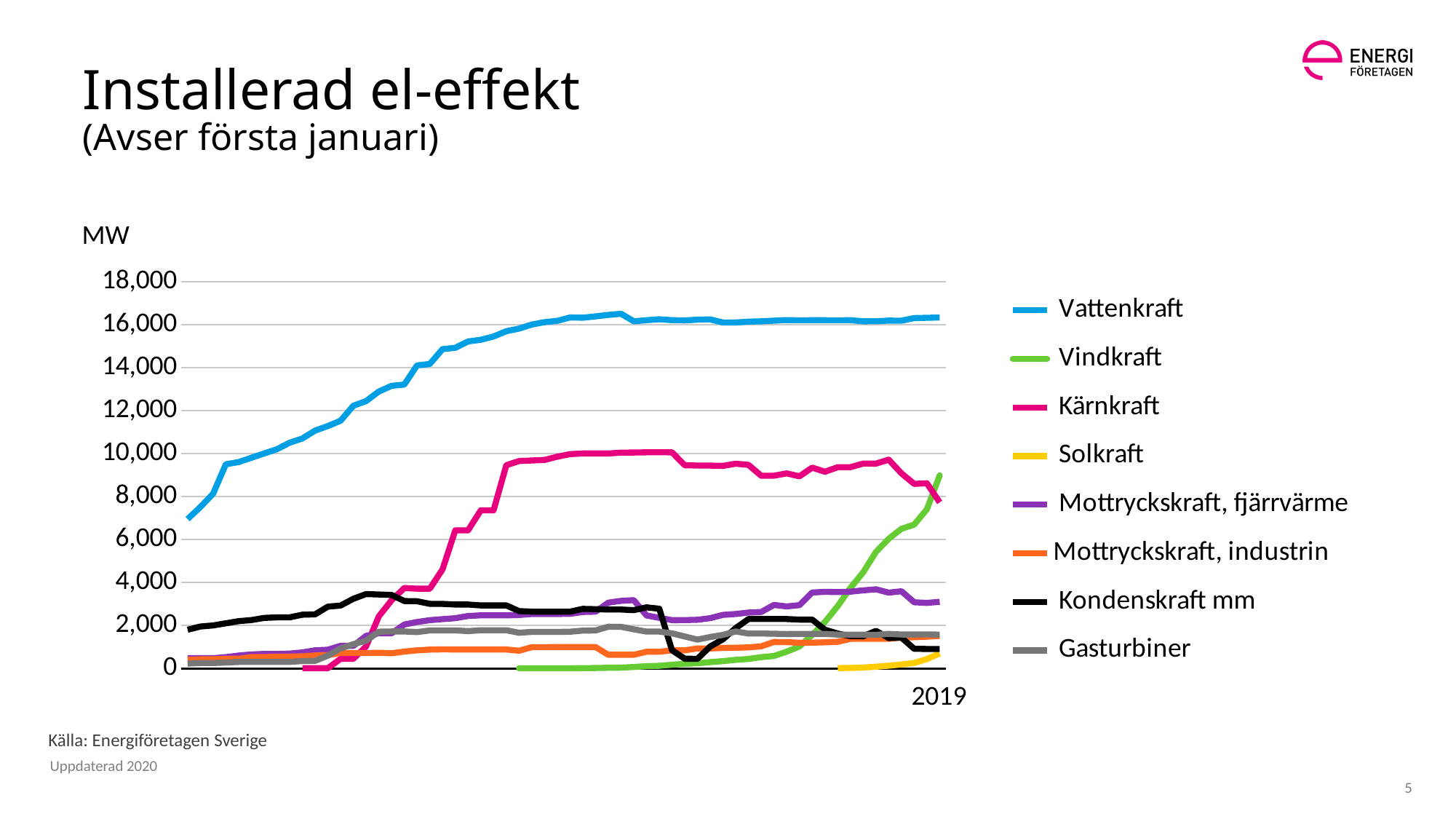
Which series has the highest values at the end of the chart (2019)? Vattenkraft What unit is shown on the y axis of the chart? MW How many series does the legend list? 8 Is the value for Vattenkraft in 2019 greater or less than 14,000? greater In 2019, which is larger: Vindkraft or Solkraft? Vindkraft Is the value for Mottryckskraft, fjärrvärme in 2019 greater or less than 2,000? greater Do the values for Vattenkraft rise or fall overall along the x axis? rise What kind of chart is shown on the slide? line chart Do the values for Vindkraft rise or fall along the x axis? rise In 2019, which is larger: Gasturbiner or Kondenskraft mm? Gasturbiner Is the value for Solkraft in 2019 greater or less than 2,000? less